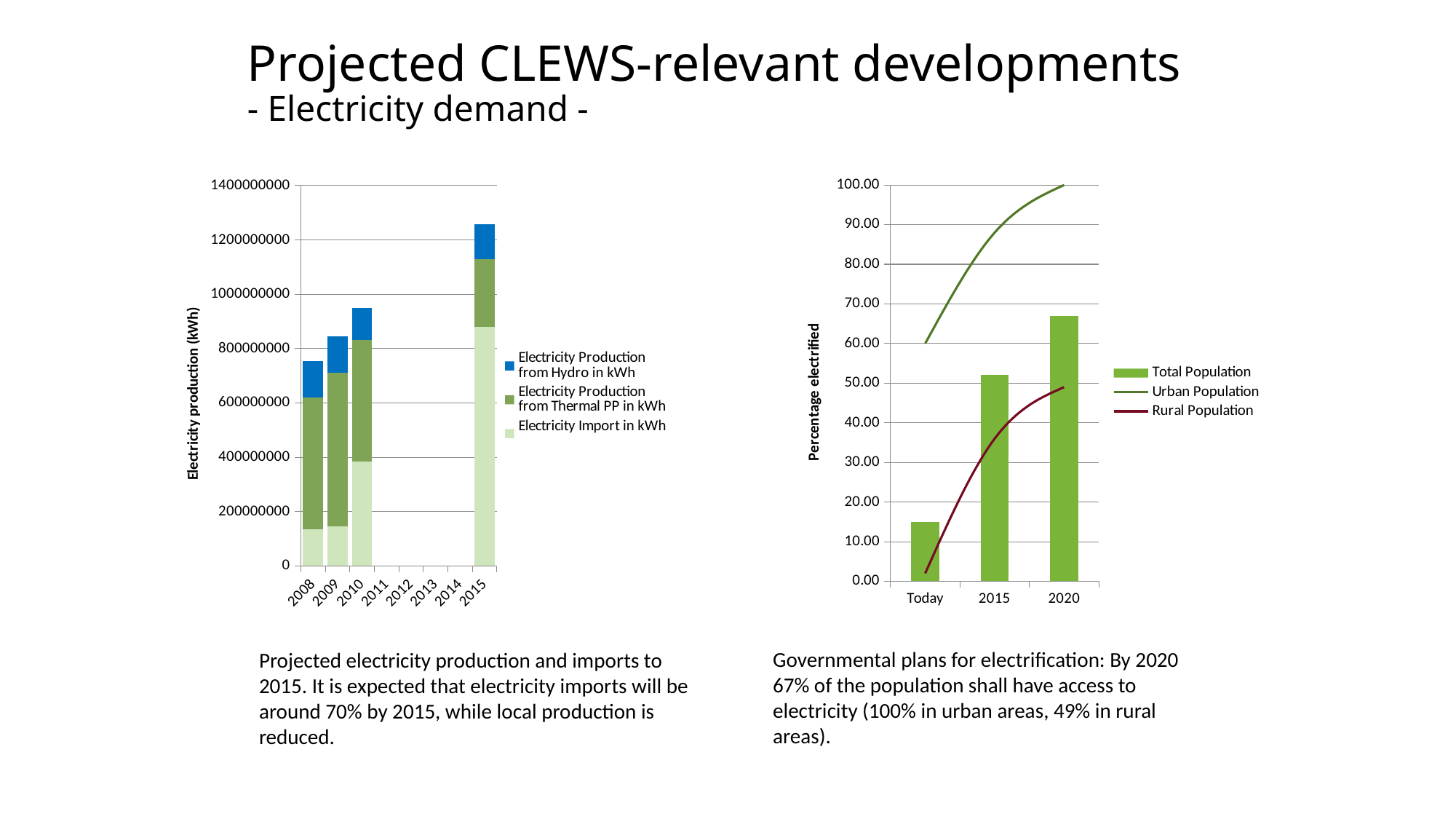
In the right chart, which category has the tallest Total Population bar? 2020 How many series does the legend of the right chart (Percentage electrified) list? 3 In the left chart, is the Electricity Import in kWh larger in 2015 or in 2008? 2015 In the left chart, is the Electricity Import in kWh for 2010 greater or less than 200000000? greater What kind of chart is the left chart showing electricity production? stacked bar chart How many series does the legend of the left chart list? 3 In the left chart, is the total stacked bar for 2015 greater or less than 1200000000? greater In the left chart, which year has the tallest stacked bar? 2015 In the right chart, does the Urban Population line rise or fall from Today to 2020? rise In the left chart, which year has the shortest stacked bar? 2008 In the right chart, is the Total Population value for 2015 greater or less than 50.00? greater In the left chart, which series is shown in blue? Electricity Production from Hydro in kWh